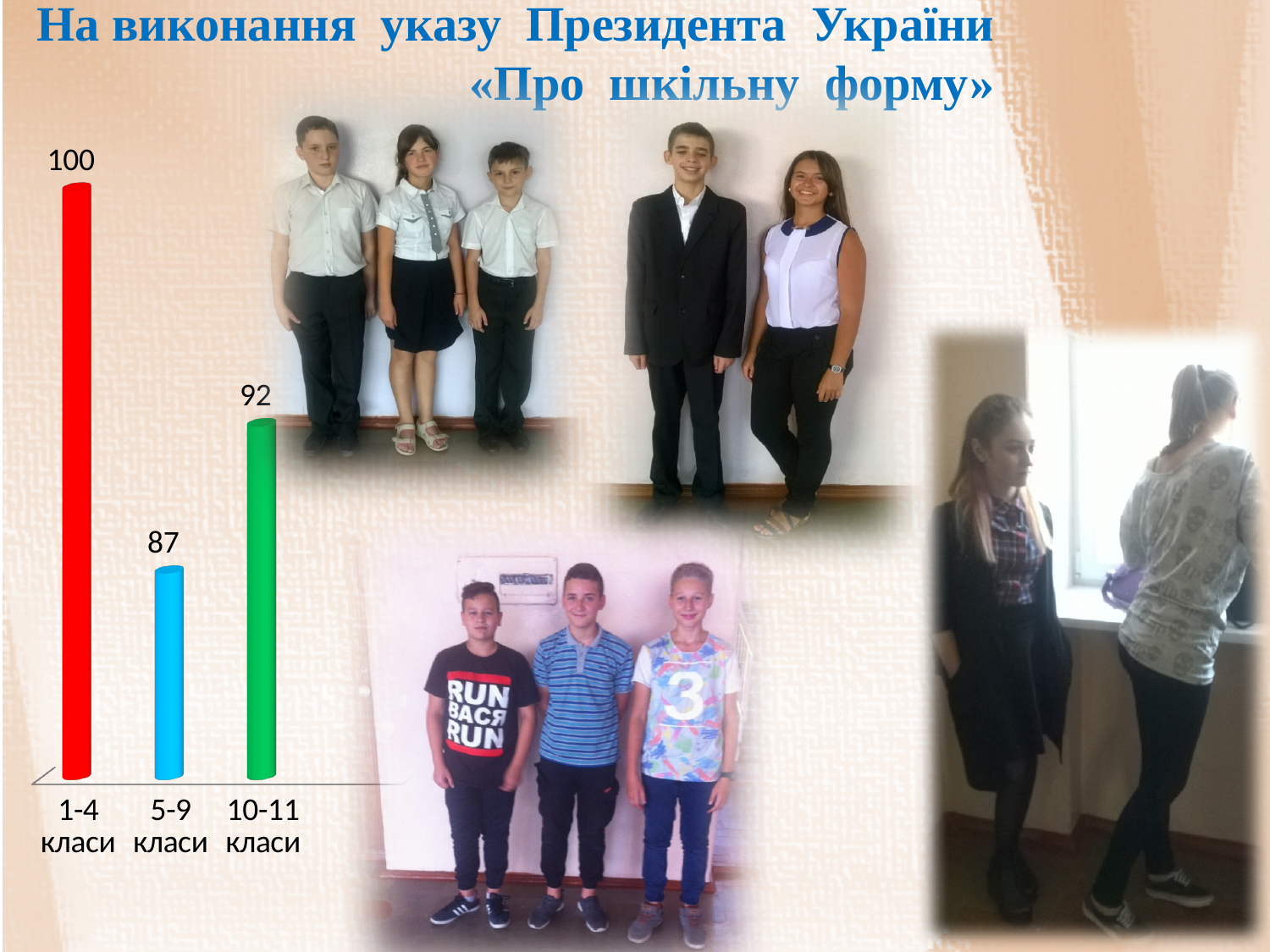
How many categories are shown in the chart? 3 What is the value for 1-4 класи? 100 Which is larger, the value for 5-9 класи or the value for 10-11 класи? 10-11 класи What is the difference between the values for 10-11 класи and 5-9 класи? 5 What colour is the bar for 1-4 класи? red Which category has the lowest value? 5-9 класи What is the value for 10-11 класи? 92 What is the value for 5-9 класи? 87 Which category has the highest value? 1-4 класи What colour is the bar for 10-11 класи? green What is the difference between the values for 1-4 класи and 5-9 класи? 13 What kind of chart is shown on the slide? bar chart